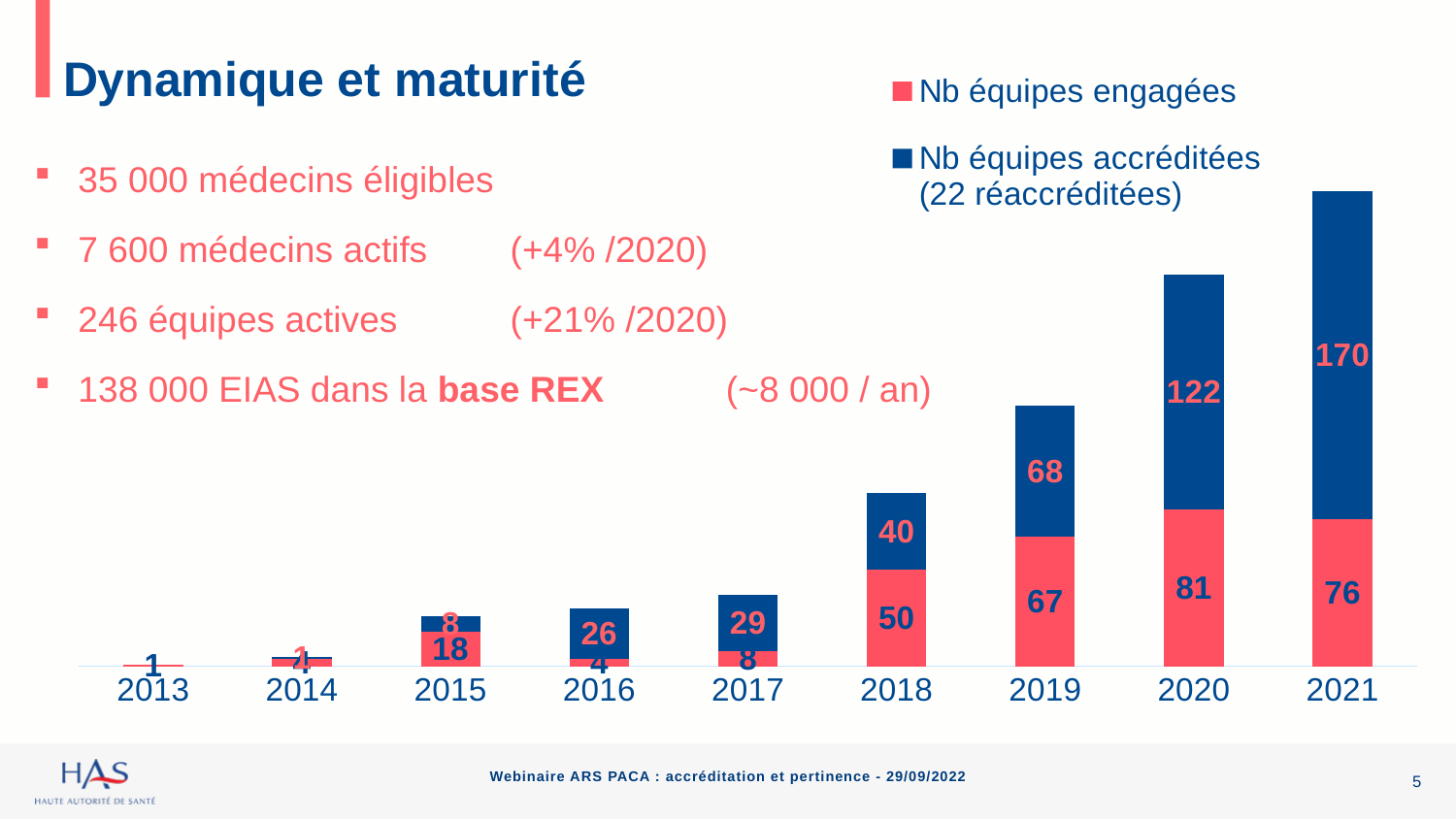
How many years are shown on the x axis of the chart? 9 In 2018, which is larger: Nb équipes engagées or Nb équipes accréditées? Nb équipes engagées What is the value of Nb équipes engagées for 2020? 81 What is the value of Nb équipes engagées for 2018? 50 What is the difference between Nb équipes accréditées in 2021 and in 2020? 48 Which year has the highest value for Nb équipes accréditées? 2021 What kind of chart is shown on the slide? Stacked bar chart What is the value of Nb équipes accréditées for 2019? 68 What is the value of Nb équipes accréditées for 2021? 170 What is the total height of the stacked bar for 2021? 246 Which year has the highest value for Nb équipes engagées? 2020 How many series does the chart legend list? 2